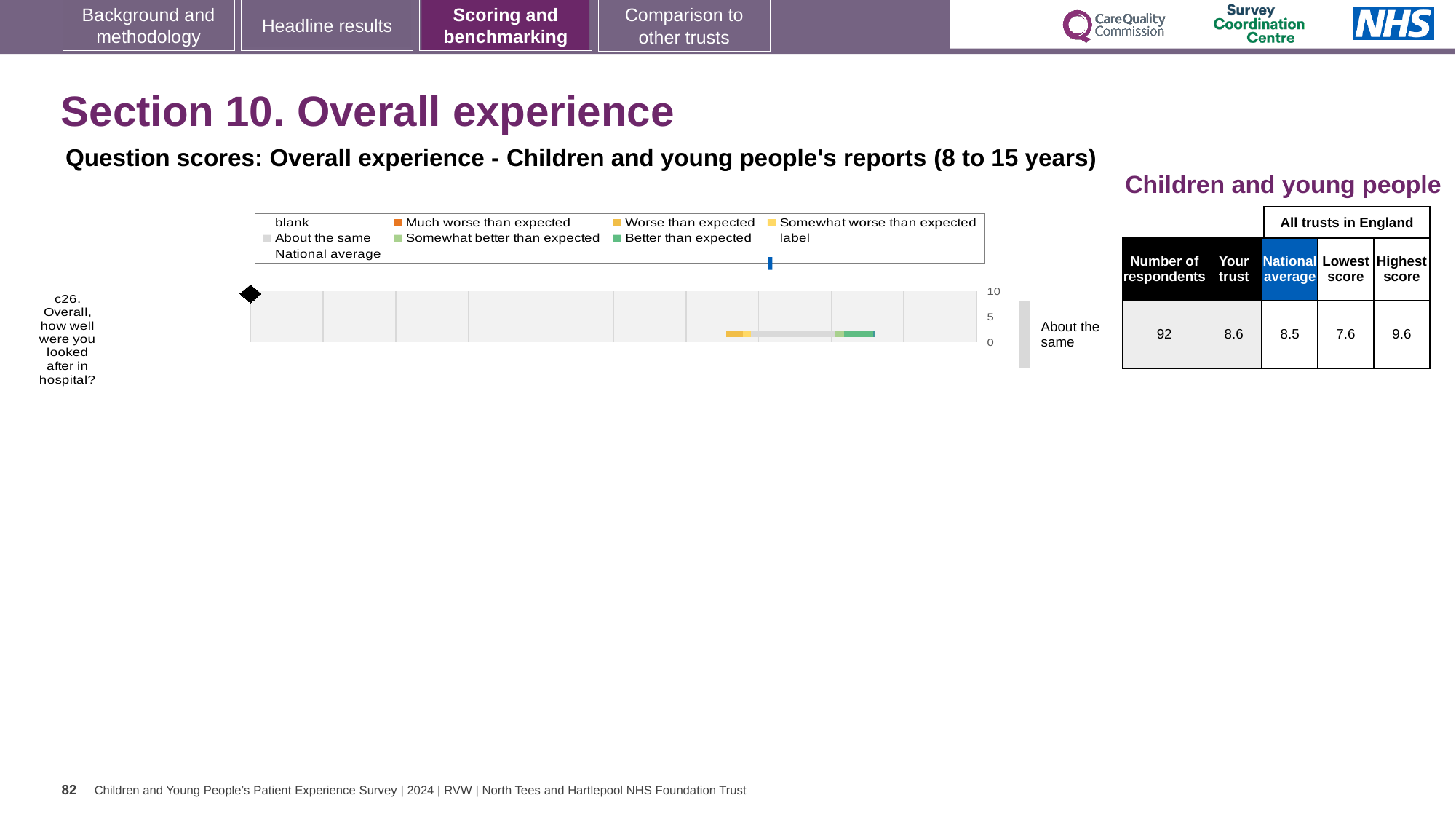
How many survey questions are plotted in the chart? 1 Is the 'Your trust' score for question c26 greater or less than 5 on the chart axis? greater What is the national average score for question c26? 8.5 What benchmark category is shown for question c26? About the same What is the highest score among all trusts in England for question c26? 9.6 Which survey question is plotted in the chart? c26. Overall, how well were you looked after in hospital? How many respondents answered question c26? 92 What kind of chart is shown on the slide? bar chart What is the 'Your trust' score for question c26? 8.6 Which is larger for question c26, the 'Your trust' score or the national average? Your trust What is the difference between the highest score and the lowest score for question c26? 2.0 What is the lowest score among all trusts in England for question c26? 7.6